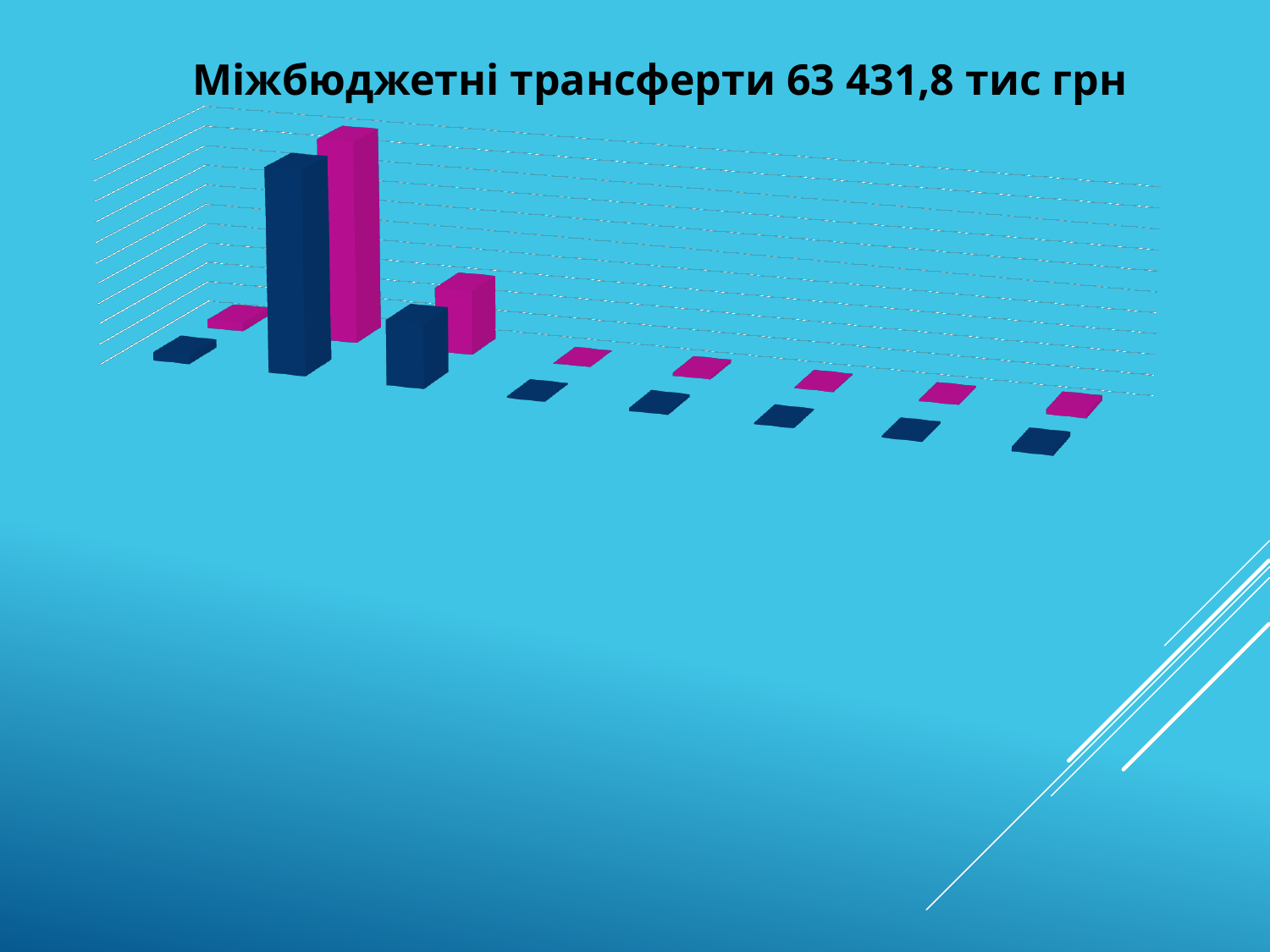
How many groups of bars are plotted along the x axis? 8 Counting from the left, which group of bars is the tallest in the chart? the second group How many differently coloured bar series are plotted in the chart? 2 What total amount is stated in the chart title? 63 431,8 тис грн What is the title of the chart on the slide? Міжбюджетні трансферти 63 431,8 тис грн What kind of chart is shown on the slide? bar chart